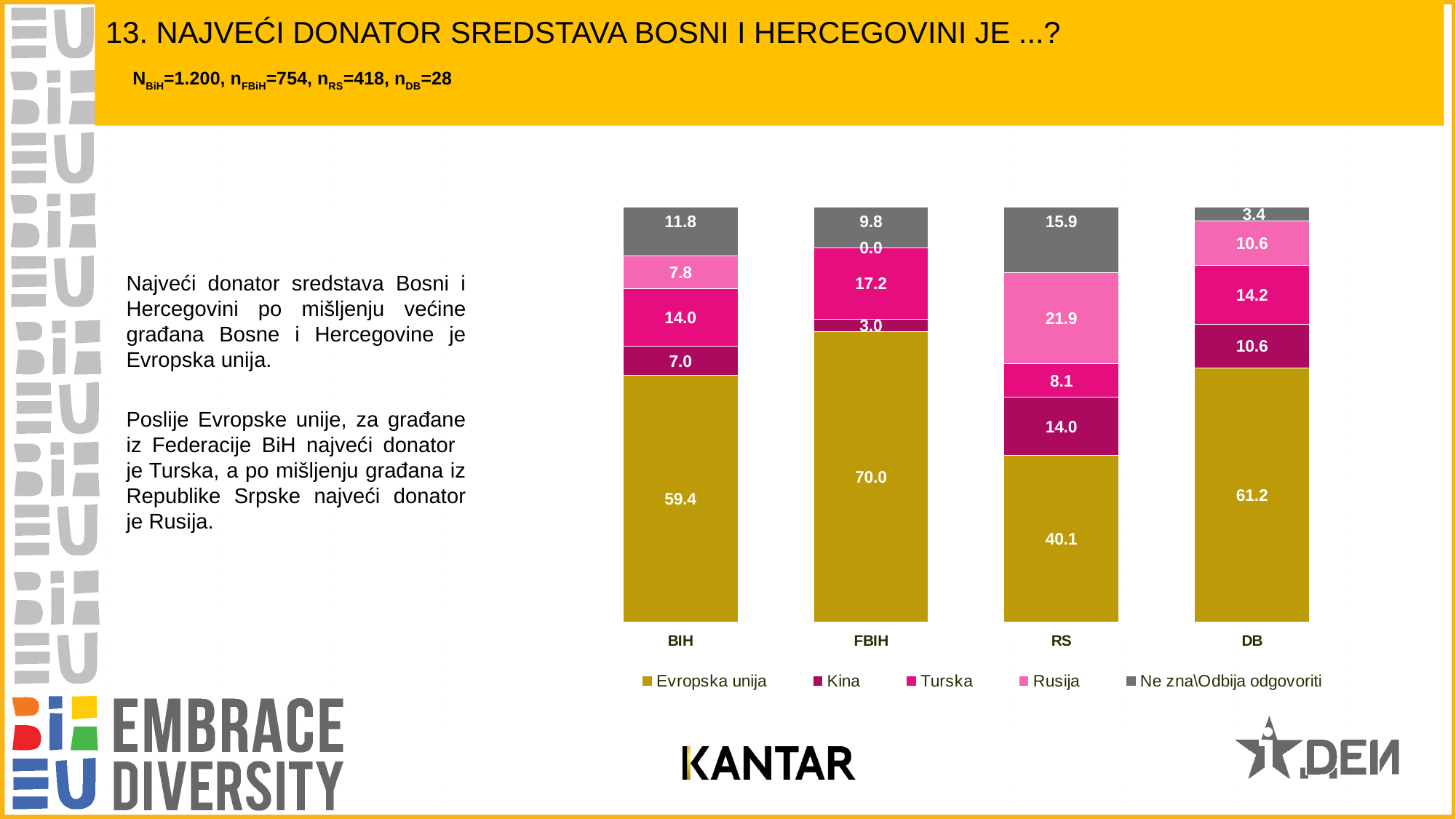
What is the value for Rusija in the RS bar? 21.9 Which is larger, the Turska value for FBIH or the Turska value for RS? FBIH Which category has the lowest value for Evropska unija? RS How many series does the legend list? 5 What type of chart is shown on the slide? Stacked bar chart Which series is shown in the gold colour at the bottom of each bar? Evropska unija What is the difference between the Evropska unija values for FBIH and RS? 29.9 What is the total of the stacked bar for BIH? 100.0 What is the value for Evropska unija in the FBIH bar? 70.0 What is the value for Ne zna\Odbija odgovoriti in the DB bar? 3.4 How many categories are shown on the x axis? 4 Which category has the highest value for Evropska unija? FBIH